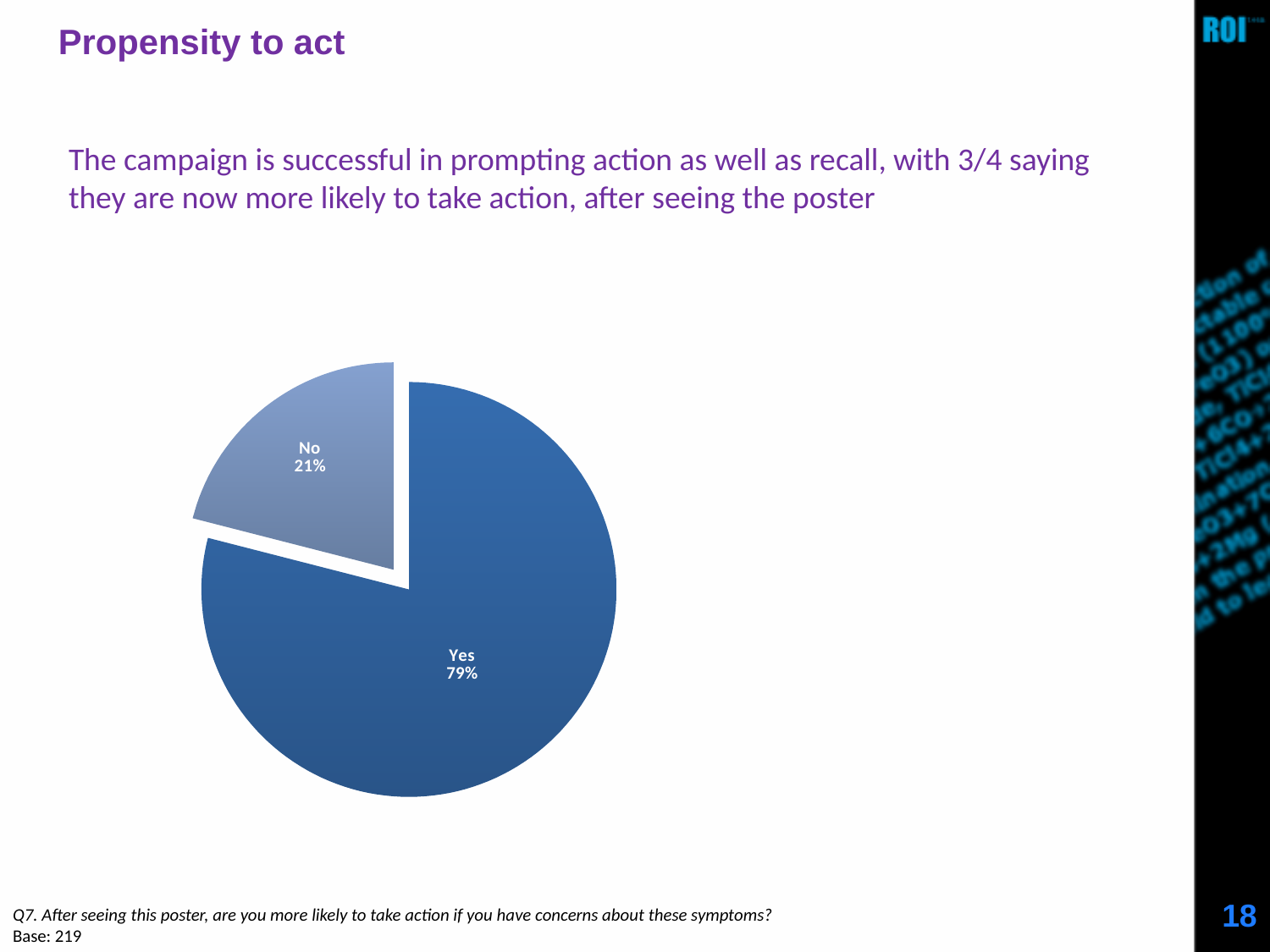
Which slice of the pie is the largest? Yes What kind of chart is shown on the slide? pie chart What share of the pie does the No slice represent? 21% What is the difference in percentage points between the Yes and No slices? 58 What percentage of respondents answered Yes? 79% What is the base (number of respondents) stated for the chart? 219 Which is larger, the Yes slice or the No slice? Yes What percentage of respondents answered No? 21% How many slices does the pie chart have? 2 What share of the pie does the Yes slice represent? 79% Which slice is pulled out (exploded) from the pie? No Which slice of the pie is the smallest? No